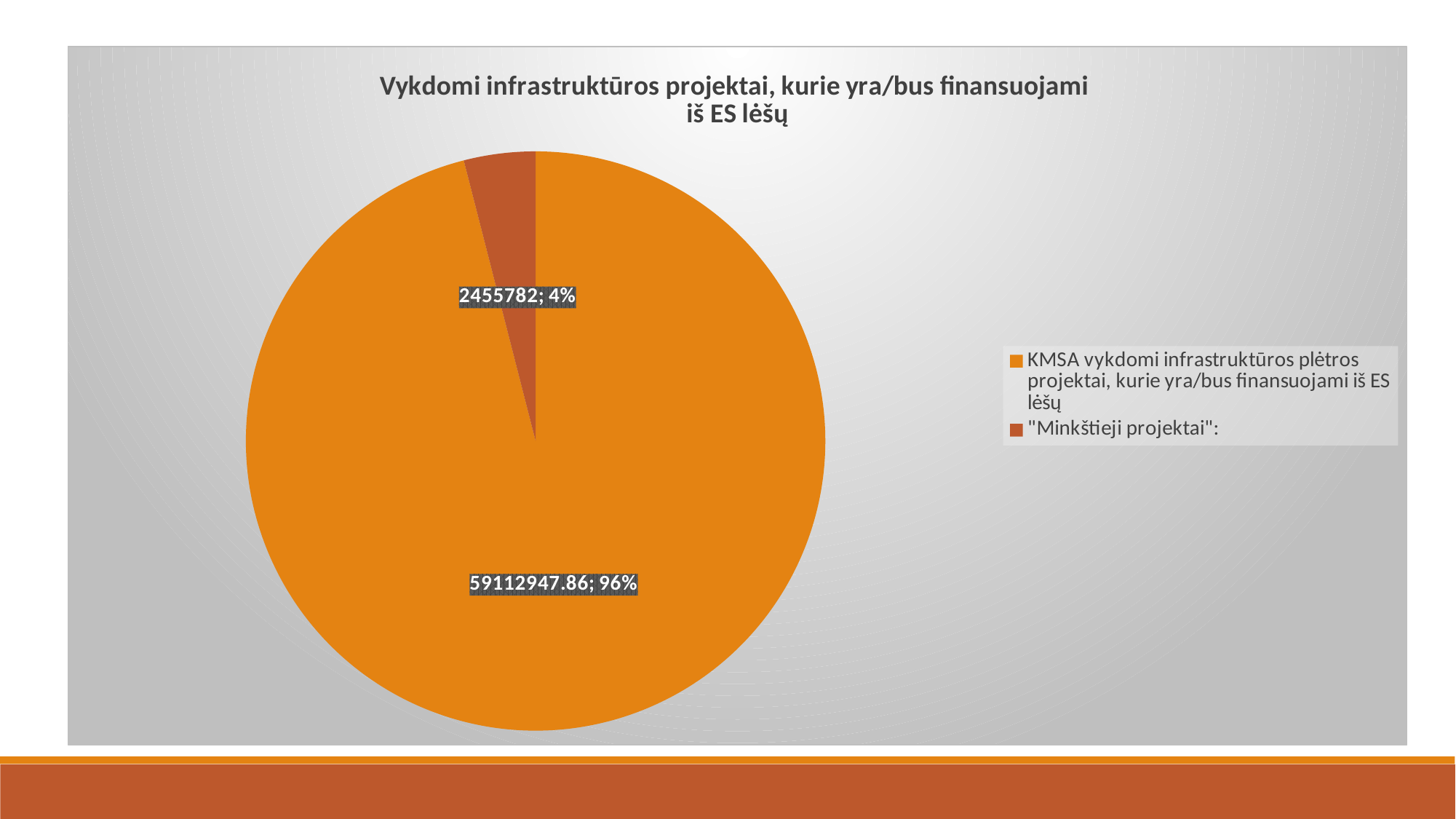
What share of the pie does "Minkštieji projektai" represent? 4% What value is shown for KMSA vykdomi infrastruktūros plėtros projektai, kurie yra/bus finansuojami iš ES lėšų? 59112947.86 Which is larger: the value for "Minkštieji projektai" or the value for KMSA vykdomi infrastruktūros plėtros projektai? KMSA vykdomi infrastruktūros plėtros projektai What kind of chart is shown on the slide? pie chart Which slice is the largest? KMSA vykdomi infrastruktūros plėtros projektai, kurie yra/bus finansuojami iš ES lėšų How many entries does the legend list? 2 How many slices does the pie chart have? 2 What is the title of the chart? Vykdomi infrastruktūros projektai, kurie yra/bus finansuojami iš ES lėšų What share of the pie does KMSA vykdomi infrastruktūros plėtros projektai, kurie yra/bus finansuojami iš ES lėšų represent? 96% What value is shown for "Minkštieji projektai"? 2455782 Which slice is the smallest? "Minkštieji projektai" What colour is the slice for "Minkštieji projektai"? dark orange (brownish orange)